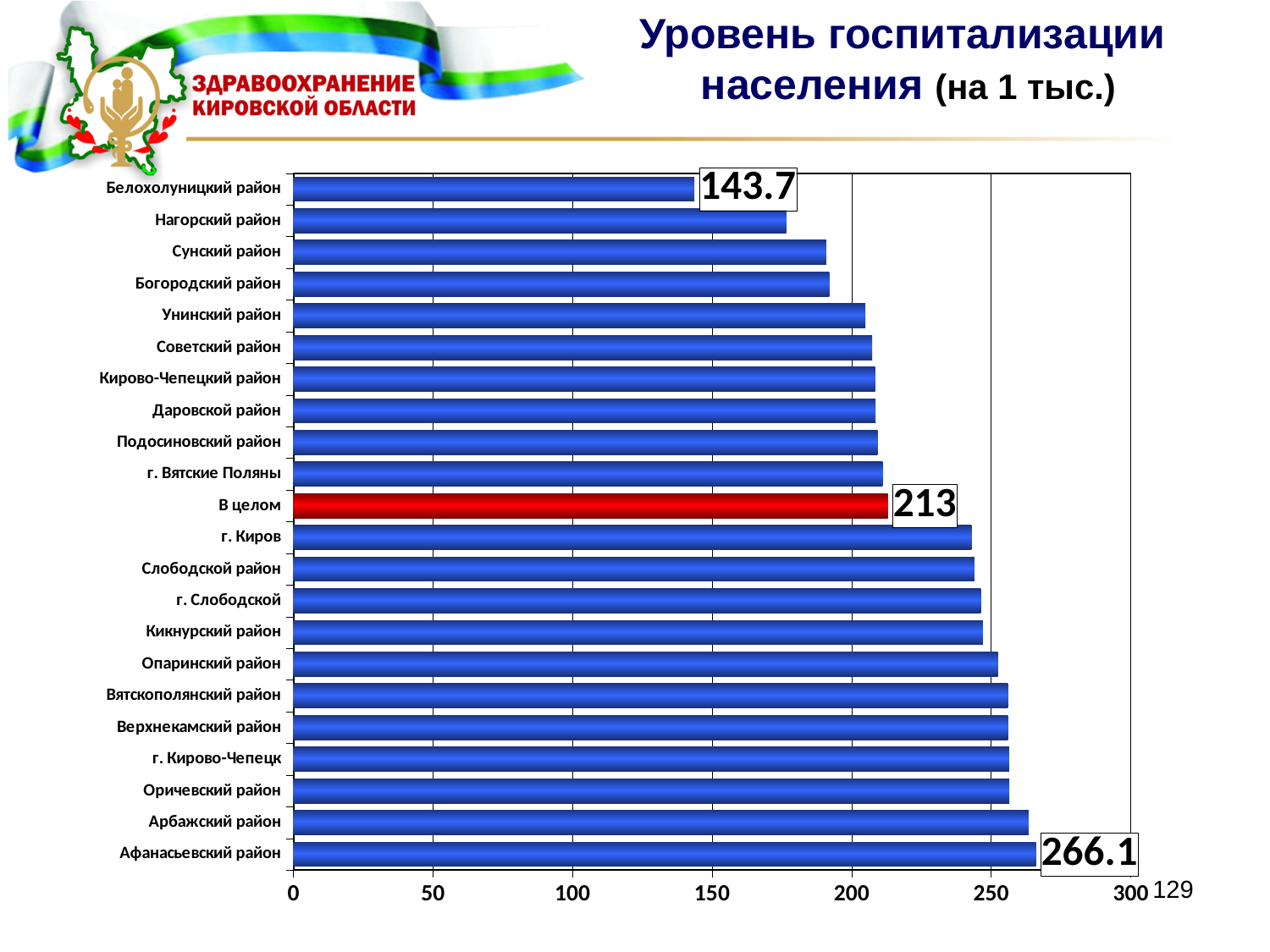
Which category has the highest hospitalization level? Афанасьевский район What is the value shown for Афанасьевский район? 266.1 What is the difference between the values for Афанасьевский район and Белохолуницкий район? 122.4 How many categories are shown in the chart? 22 Which category is shown with a red bar? В целом What is the hospitalization level for Белохолуницкий район? 143.7 Is the value for Арбажский район greater or less than 250? greater By how much does Афанасьевский район exceed the overall value (В целом)? 53.1 What is the value shown for В целом? 213 Is the value for Нагорский район greater or less than 200? less Which is larger, the value for г. Киров or the value for Нагорский район? г. Киров Which category has the lowest hospitalization level? Белохолуницкий район